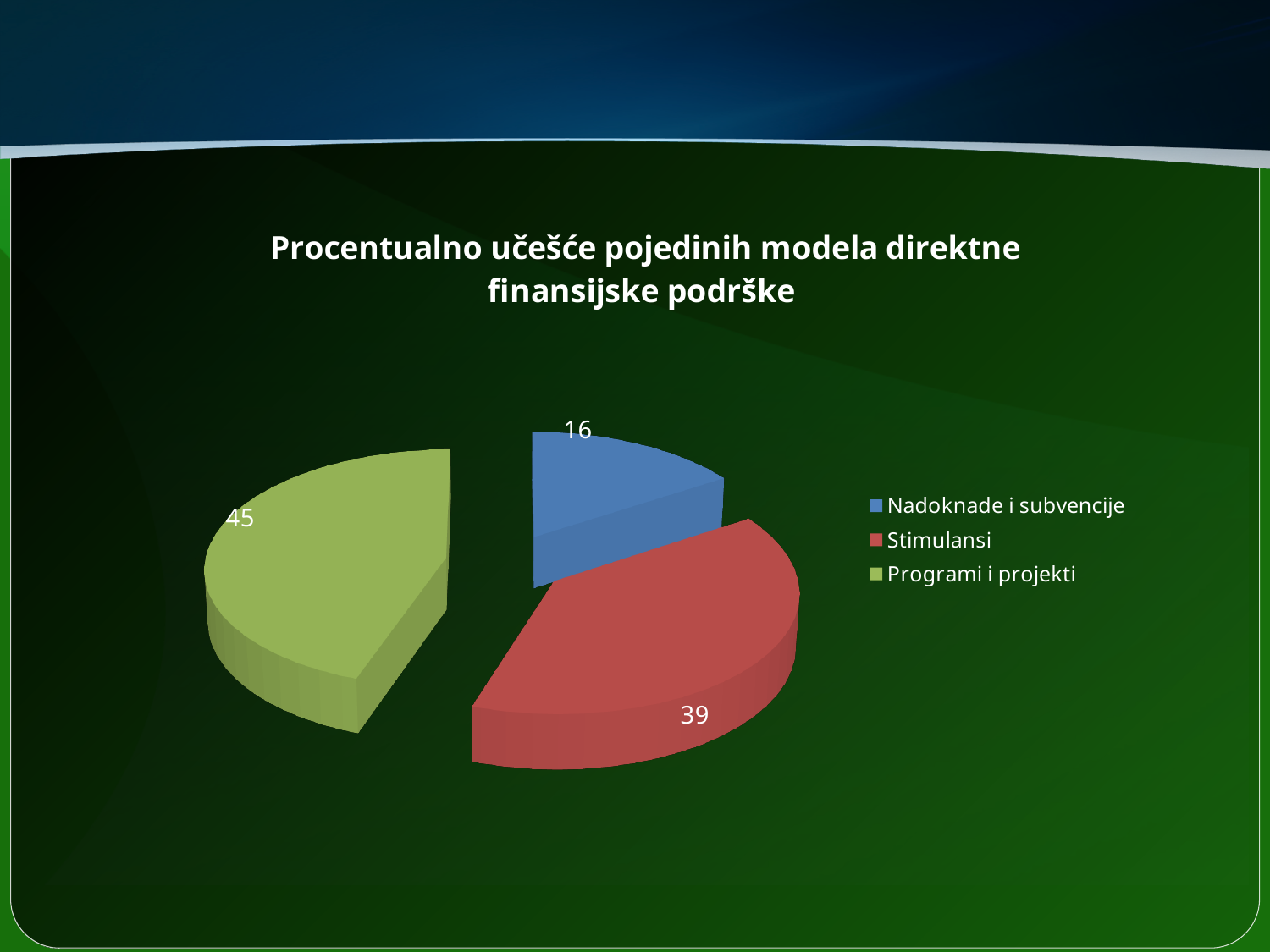
What kind of chart is shown on the slide? Pie chart What is the difference between the values for Stimulansi and Nadoknade i subvencije? 23 How many categories does the pie chart show? 3 Which colour represents Stimulansi in the chart? Red What is the value for Programi i projekti? 45 What is the title of the chart? Procentualno učešće pojedinih modela direktne finansijske podrške Which is larger, Stimulansi or Nadoknade i subvencije? Stimulansi What is the difference between the values for Programi i projekti and Stimulansi? 6 What is the value for Stimulansi? 39 Which category has the smallest slice? Nadoknade i subvencije What is the value for Nadoknade i subvencije? 16 Which category has the largest slice? Programi i projekti